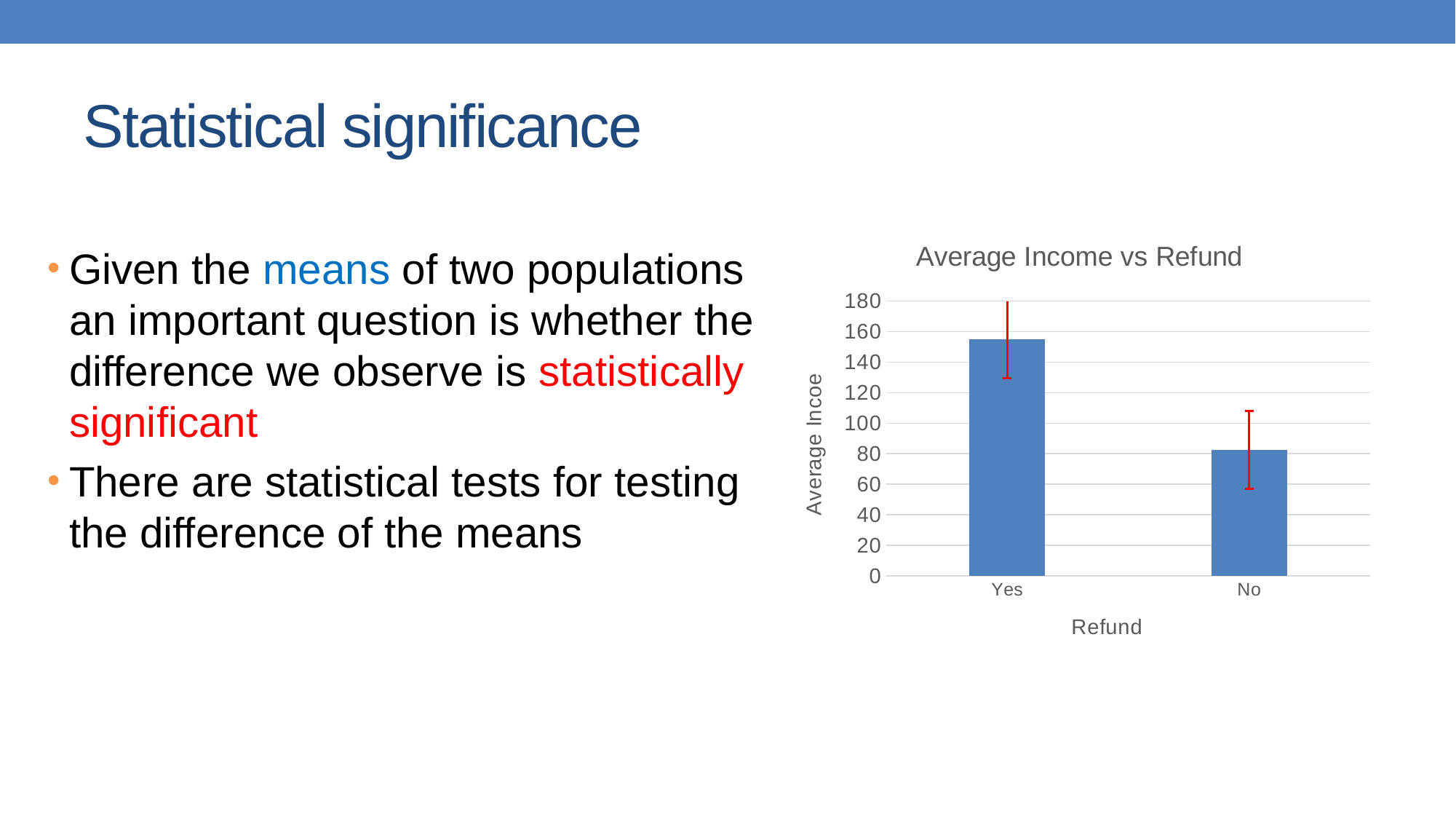
Is the value for No greater or less than 100? less Which category has the highest average income in the chart? Yes Is the value for No greater or less than 60? greater Do the bar values rise or fall from Yes to No along the x axis? fall Which category has the lowest average income in the chart? No What kind of chart is shown on the slide? bar chart How many categories are plotted on the x axis of the chart? 2 What is the title of the chart? Average Income vs Refund Which has a larger average income, Yes or No? Yes Is the value for Yes greater or less than 140? greater What is the label on the x axis of the chart? Refund